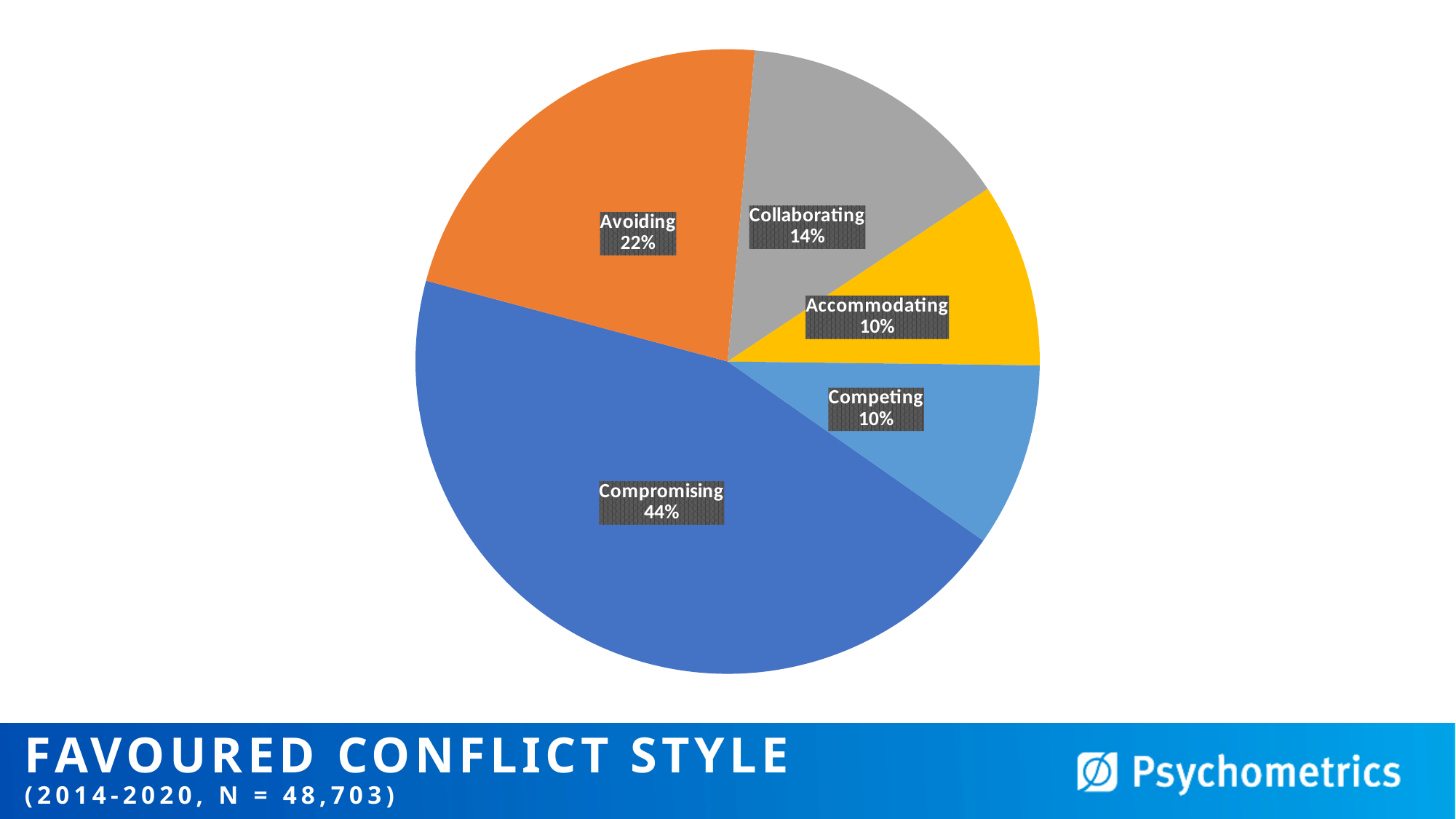
Which conflict style has the largest share of the pie? Compromising What colour is the Compromising slice? Blue What is the difference in percentage points between Collaborating and Competing? 4 Which is larger, the share for Avoiding or the share for Collaborating? Avoiding How many slices does the pie chart have? 5 What is the difference in percentage points between Compromising and Avoiding? 22 What percentage of the pie is Accommodating? 10% What is the title of the chart on the slide? Favoured Conflict Style What percentage of the pie is Avoiding? 22% What percentage of the pie is Collaborating? 14% What percentage of the pie is Compromising? 44% What kind of chart is shown on the slide? Pie chart